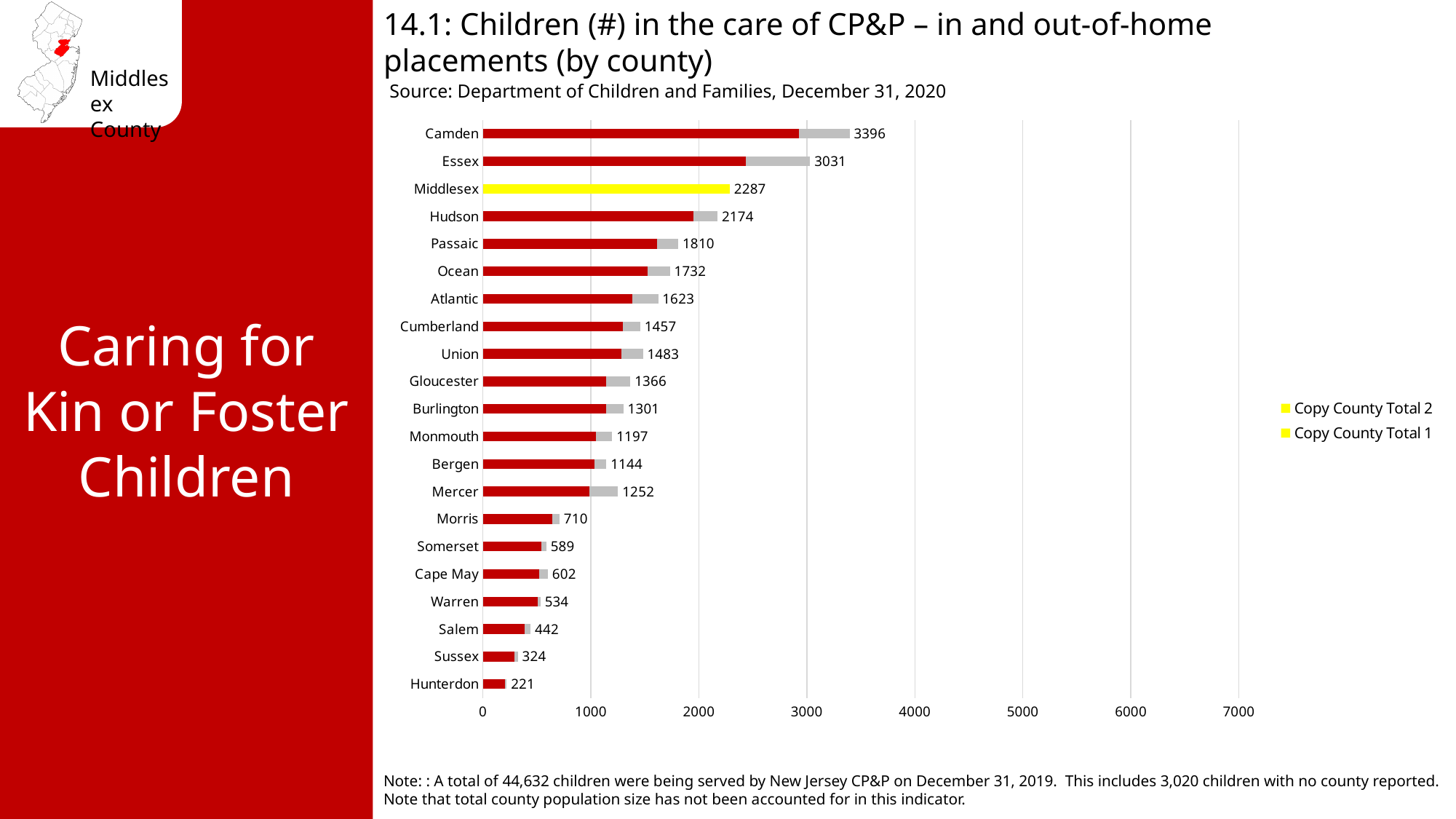
What is the total number of children in the care of CP&P for Middlesex County? 2287 What is the difference between the values for Camden and Essex? 365 What kind of chart is shown on the slide? bar chart What value is shown for Mercer County? 1252 Which has a larger value, Union or Cumberland? Union Which county has the lowest number of children in the care of CP&P? Hunterdon What value is shown for Hudson County? 2174 How many counties are shown on the chart? 21 What is the difference between the values for Morris and Somerset? 121 Which county has the highest number of children in the care of CP&P? Camden How many series does the legend list? 2 Is the red segment of the Camden bar greater or less than 2000? greater